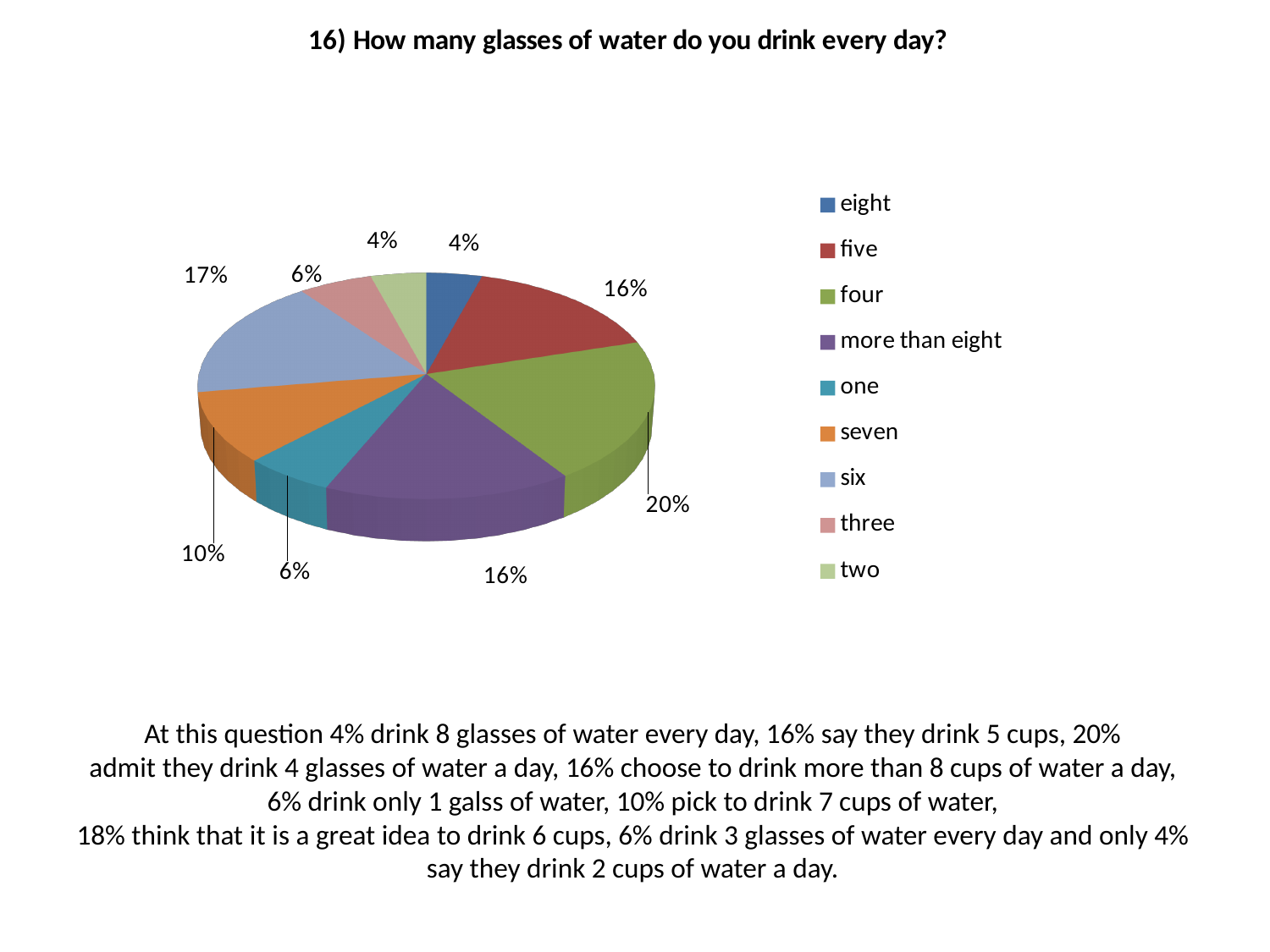
What percentage of respondents drink four glasses of water a day? 20% What is the combined share of respondents who drink eight glasses and two glasses? 8% Which is larger, the share for six glasses or the share for five glasses? six Which category has the largest share of the pie? four What is the title of the chart? 16) How many glasses of water do you drink every day? What percentage of respondents drink seven glasses of water a day? 10% Which legend entry is shown in purple? more than eight What percentage of respondents drink more than eight glasses of water a day? 16% How many categories does the legend list? 9 What is the difference between the share for four glasses and the share for seven glasses? 10% What percentage of respondents drink six glasses of water a day? 17% What type of chart is shown on the slide? pie chart